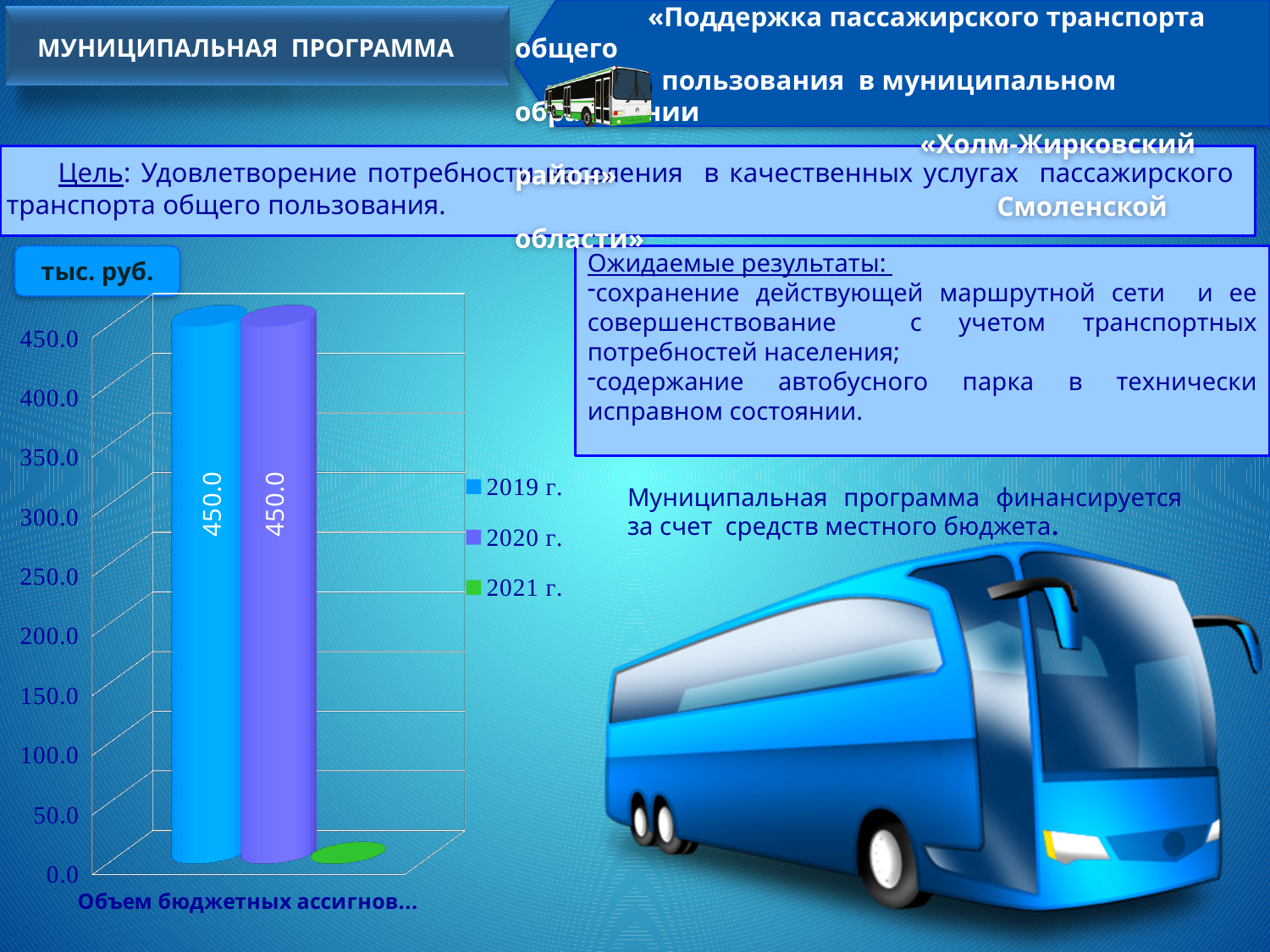
What is the value for 2020 г. on the chart? 450.0 What kind of chart is shown on the slide? bar chart What is the value for 2019 г. on the chart? 450.0 How many series does the chart legend list? 3 Which series has the lowest value on the chart? 2021 г. What unit is indicated in the label above the chart's vertical axis? тыс. руб. Which is larger, the value for 2019 г. or the value for 2020 г.? They are equal How many categories are shown on the x axis of the chart? 1 Is the value for 2021 г. greater or less than 50.0? less What is the difference between the values for 2019 г. and 2020 г.? 0.0 What colour represents 2021 г. in the chart legend? green